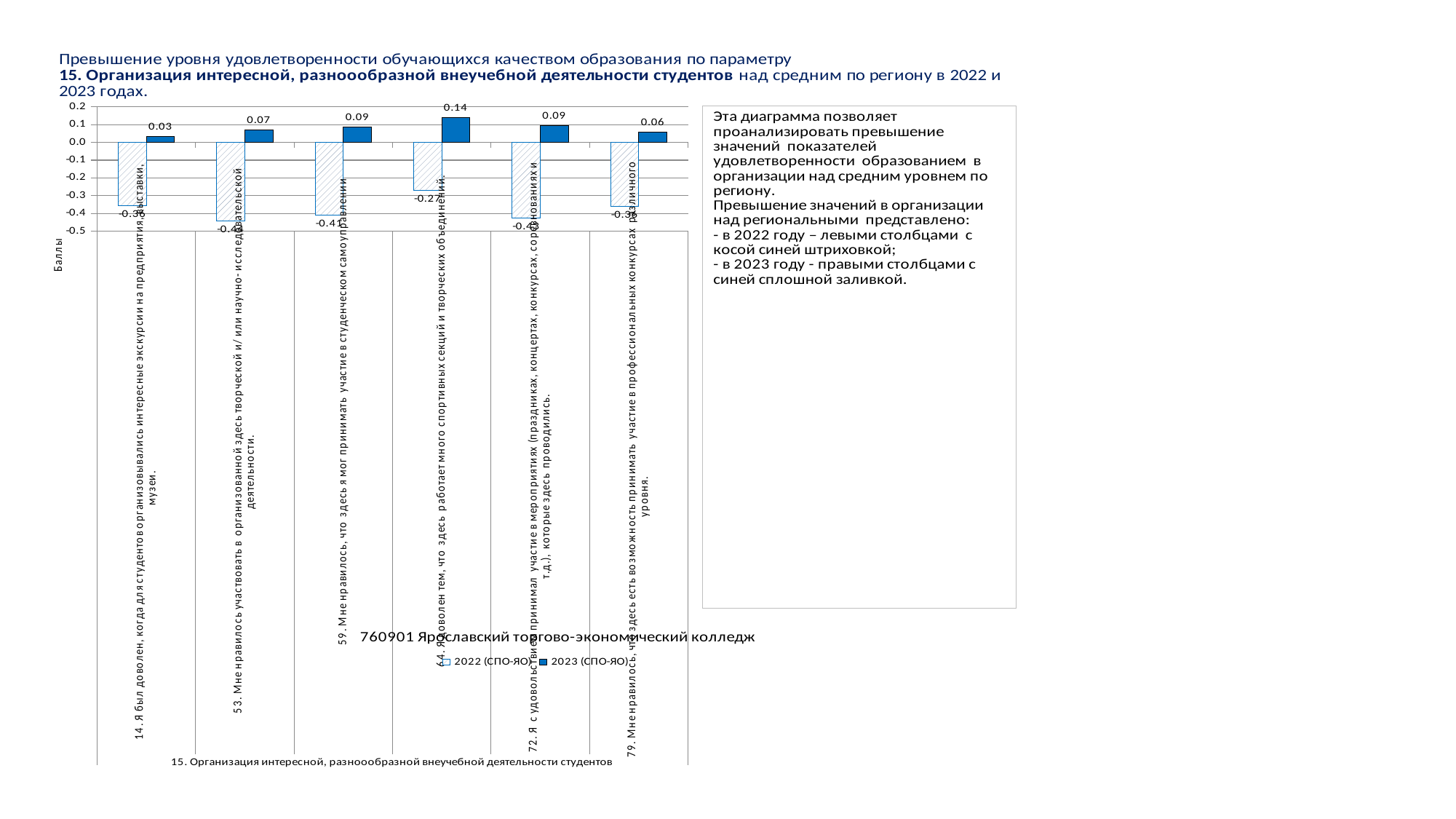
How many questions (categories) are shown on the x axis of the chart? 6 Is the 2022 (СПО-ЯО) value for question 14 greater or less than -0.3? less What is the difference between the 2023 and 2022 (СПО-ЯО) values for question 64? 0.41 What is the 2023 (СПО-ЯО) value for question 14 ("Я был доволен, когда для студентов организовывались интересные экскурсии...")? 0.03 Which question has the highest 2023 (СПО-ЯО) value? 64 What type of chart is shown on the slide? bar chart What is the difference between the 2023 (СПО-ЯО) values for question 64 and question 14? 0.11 What is the 2023 (СПО-ЯО) value for question 64 ("Я доволен тем, что здесь работает много спортивных секций и творческих объединений")? 0.14 What is the 2022 (СПО-ЯО) value for question 64 ("Я доволен тем, что здесь работает много спортивных секций и творческих объединений")? -0.27 Which question has the lowest 2023 (СПО-ЯО) value? 14 How many series does the chart legend list? 2 Which has the larger 2023 (СПО-ЯО) value: question 53 or question 59? question 59